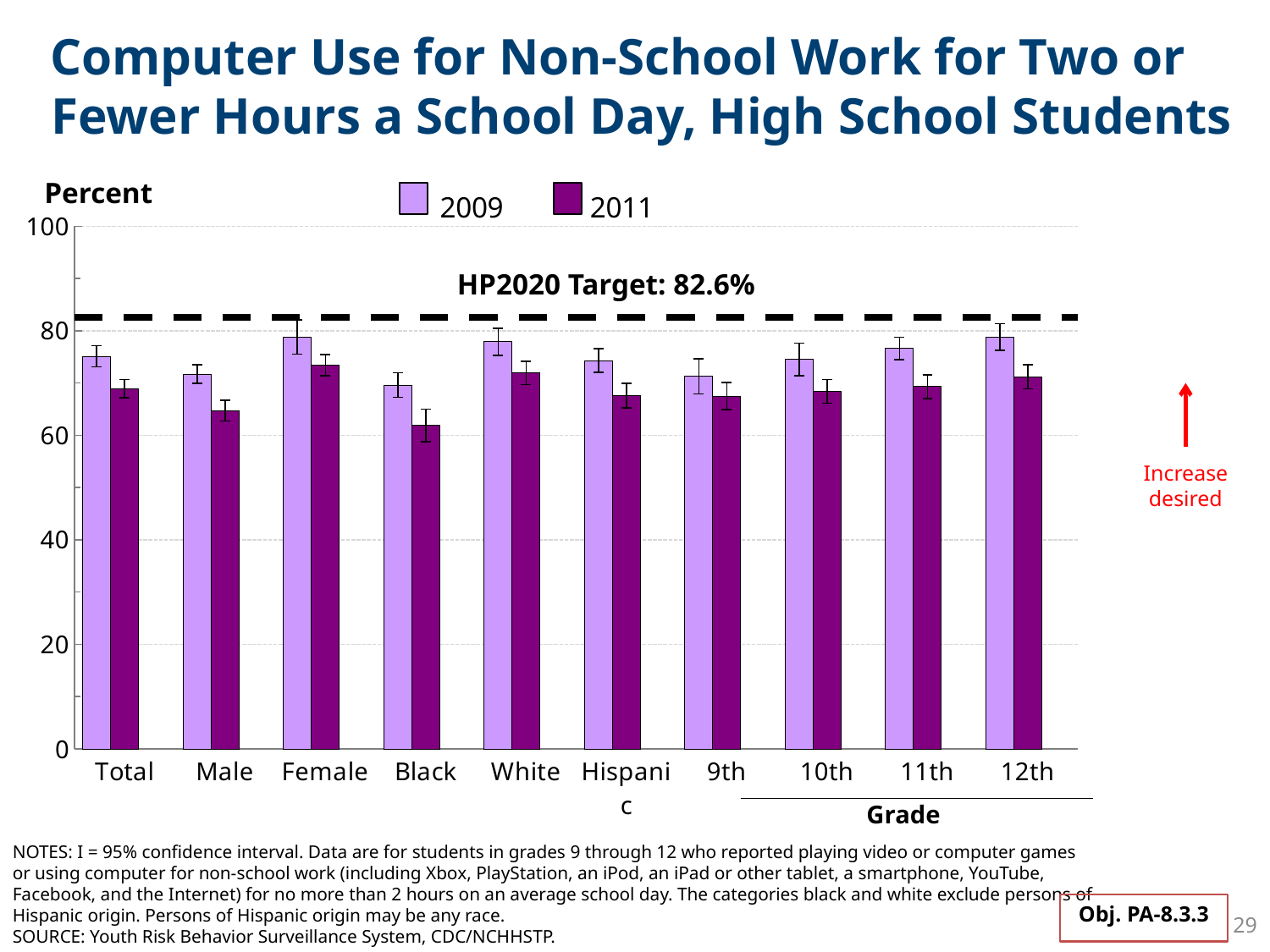
What is the HP2020 Target value shown on the chart? 82.6% For 2011, which is larger, the value for Black or the value for White? White How many categories are shown along the x axis? 10 Which category has the lowest value for 2011? Black Which year does the darker purple bar represent? 2011 How many series does the legend list? 2 Is the value for Total in 2009 greater or less than 80? less For the Total category, which year has the larger value, 2009 or 2011? 2009 Is the value for Male in 2011 greater or less than 60? greater For 2009, which is larger, the value for Male or the value for Female? Female Across the grades from 9th to 12th, do the 2009 values rise or fall? rise What kind of chart is shown on the slide? bar chart